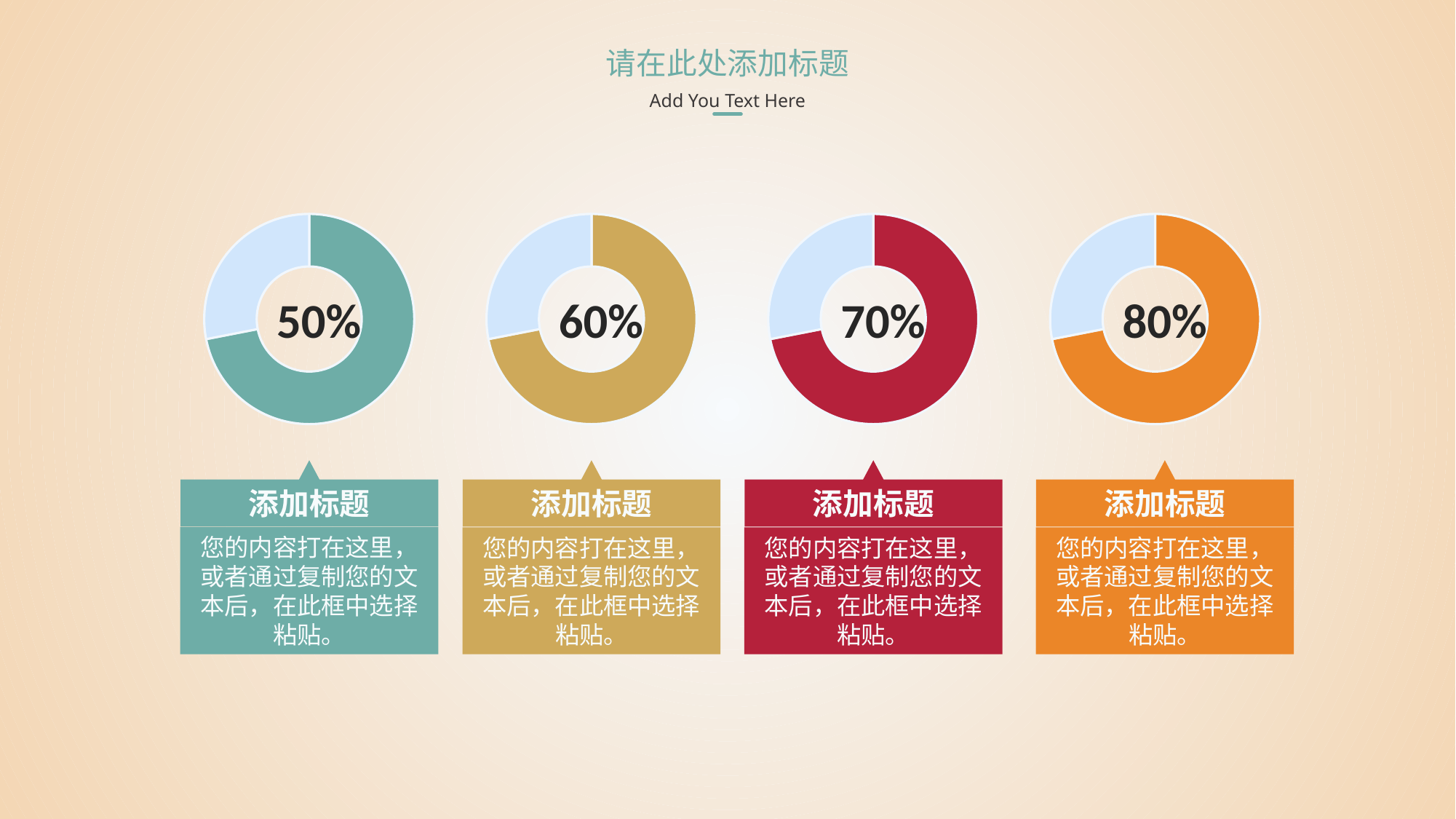
What is the difference between the percentage printed on the rightmost (orange) donut chart and the leftmost (teal) donut chart? 30% Which of the four donut charts shows the lowest printed percentage? The leftmost (teal) chart, 50% Do the printed percentages rise or fall when reading the donut charts from left to right? Rise How many donut charts are shown on the slide? 4 What colour is the filled portion of the donut chart labelled 70%? Red Which printed percentage is larger: the red donut chart or the gold donut chart? The red donut chart (70%) What value is printed in the centre of the rightmost (orange) donut chart? 80% What kind of chart is used to display the percentages on this slide? Donut chart Which of the four donut charts shows the highest printed percentage? The rightmost (orange) chart, 80% What value is printed in the centre of the second (gold) donut chart from the left? 60% What value is printed in the centre of the third (red) donut chart from the left? 70% What value is printed in the centre of the leftmost (teal) donut chart? 50%